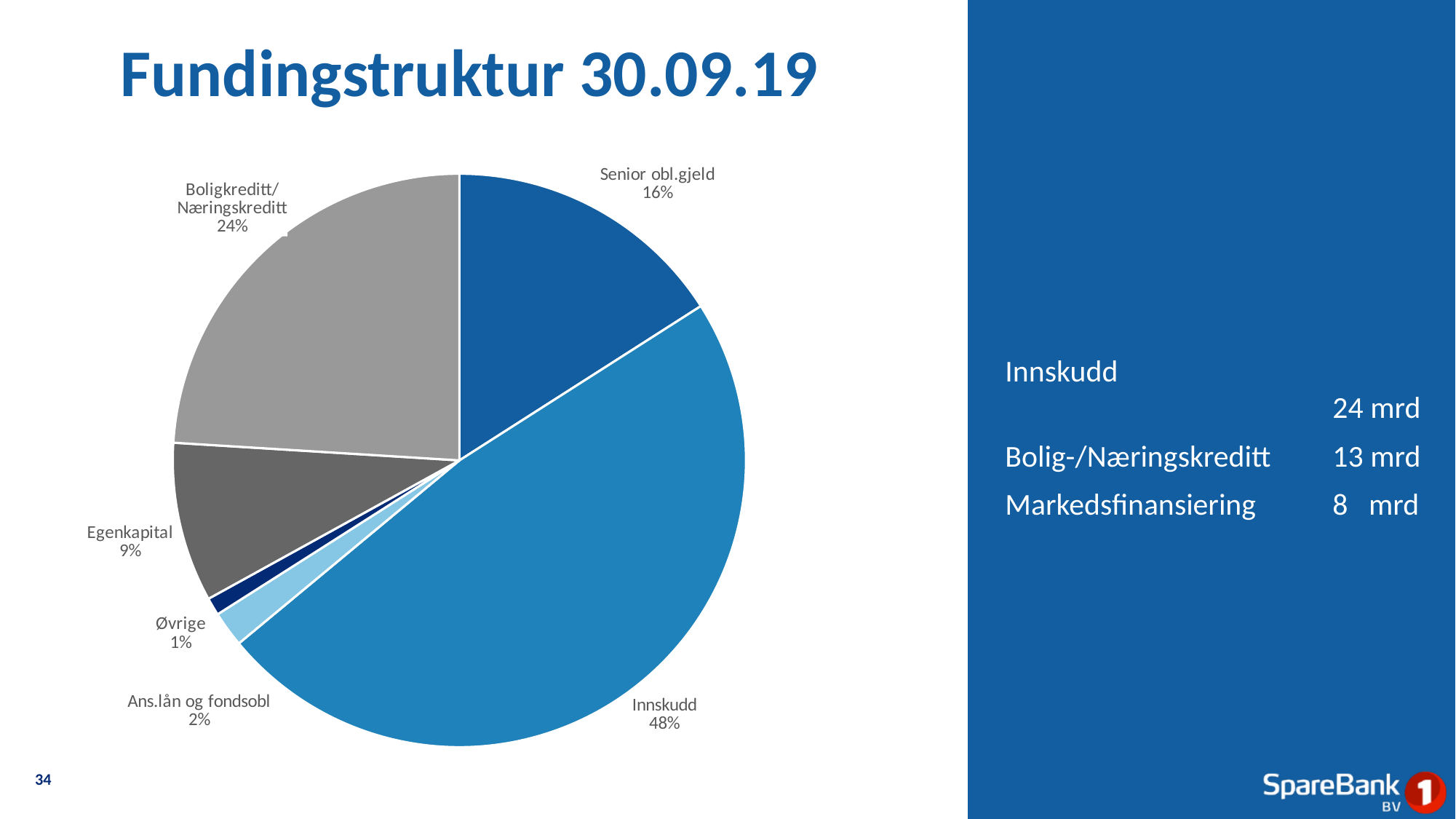
Which category has the largest slice of the pie? Innskudd How many slices does the pie chart have? 6 What is the value shown for Senior obl.gjeld? 16% Which category has the smallest slice of the pie? Øvrige What is the value shown for Egenkapital? 9% Which is larger, Senior obl.gjeld or Egenkapital? Senior obl.gjeld What share of the pie does Innskudd represent? 48% What is the difference in percentage points between Innskudd and Boligkreditt/Næringskreditt? 24 What is the value shown for Boligkreditt/Næringskreditt? 24% What is the value shown for Ans.lån og fondsobl? 2% What is the title of the slide containing the chart? Fundingstruktur 30.09.19 What kind of chart is shown on the slide? Pie chart